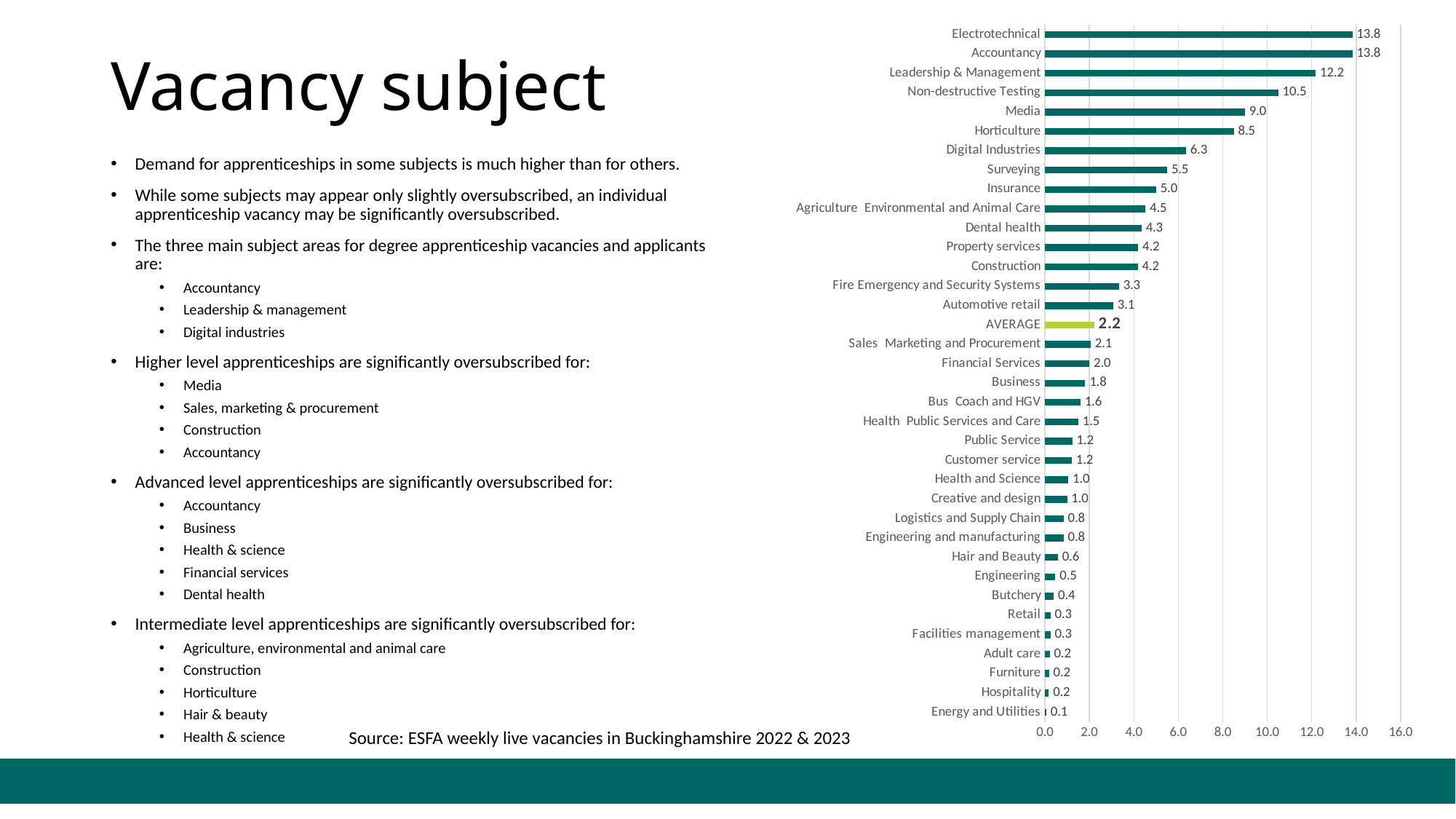
Is the value for Non-destructive Testing greater or less than 10.0? greater How many bars are plotted on the chart, including AVERAGE? 36 What is the value for Media? 9.0 Which is larger, the value for Insurance or the value for Business? Insurance What is the difference between the values for Digital Industries and Surveying? 0.8 Which category has the lowest value? Energy and Utilities What is the difference between the values for Leadership & Management and Non-destructive Testing? 1.7 What is the value for Horticulture? 8.5 What kind of chart is shown on the slide? Bar chart Which bar is shown in a different colour from the rest? AVERAGE What is the value for Dental health? 4.3 What is the value shown for AVERAGE? 2.2